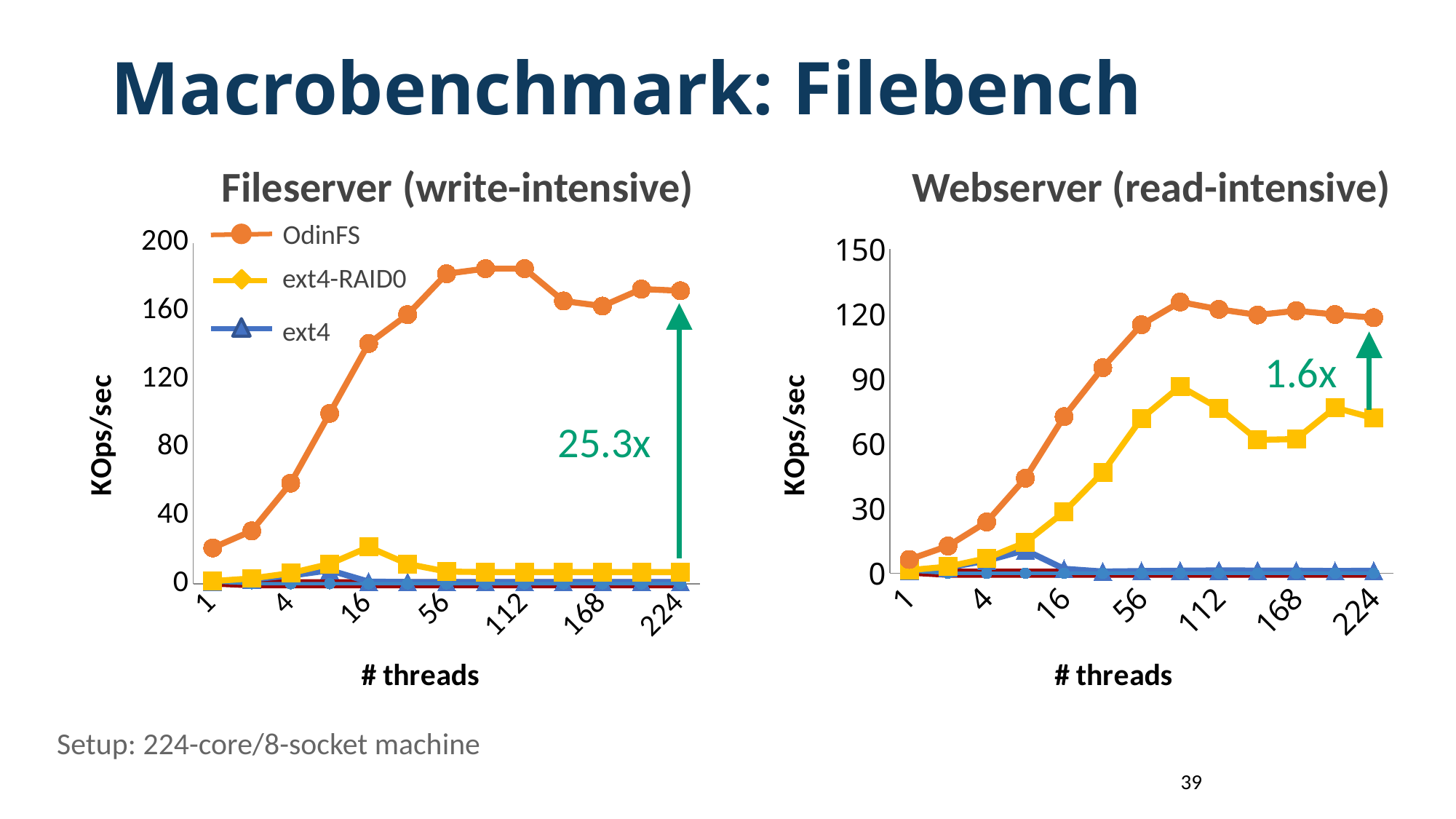
In the Webserver (read-intensive) chart, at 56 threads, which is larger: OdinFS or ext4-RAID0? OdinFS How many tick labels are shown on the x axis of the Webserver (read-intensive) chart? 7 In the Fileserver (write-intensive) chart, is the ext4-RAID0 value at 224 threads greater or less than 40? less What is the y-axis label of the Webserver (read-intensive) chart? KOps/sec In the Fileserver (write-intensive) chart, which series has the highest values at 224 threads? OdinFS What kind of chart is the Fileserver (write-intensive) chart? line chart What speedup annotation is printed on the Fileserver (write-intensive) chart? 25.3x In the Fileserver (write-intensive) chart, does the OdinFS line rise or fall between 1 and 56 threads? rise In the Webserver (read-intensive) chart, which series has the lowest values at 224 threads? ext4 In the Webserver (read-intensive) chart, is the ext4-RAID0 value at 224 threads greater or less than 60? greater How many series does the legend on the Fileserver (write-intensive) chart list? 3 In the Fileserver (write-intensive) chart, is the OdinFS value at 224 threads greater or less than 160? greater